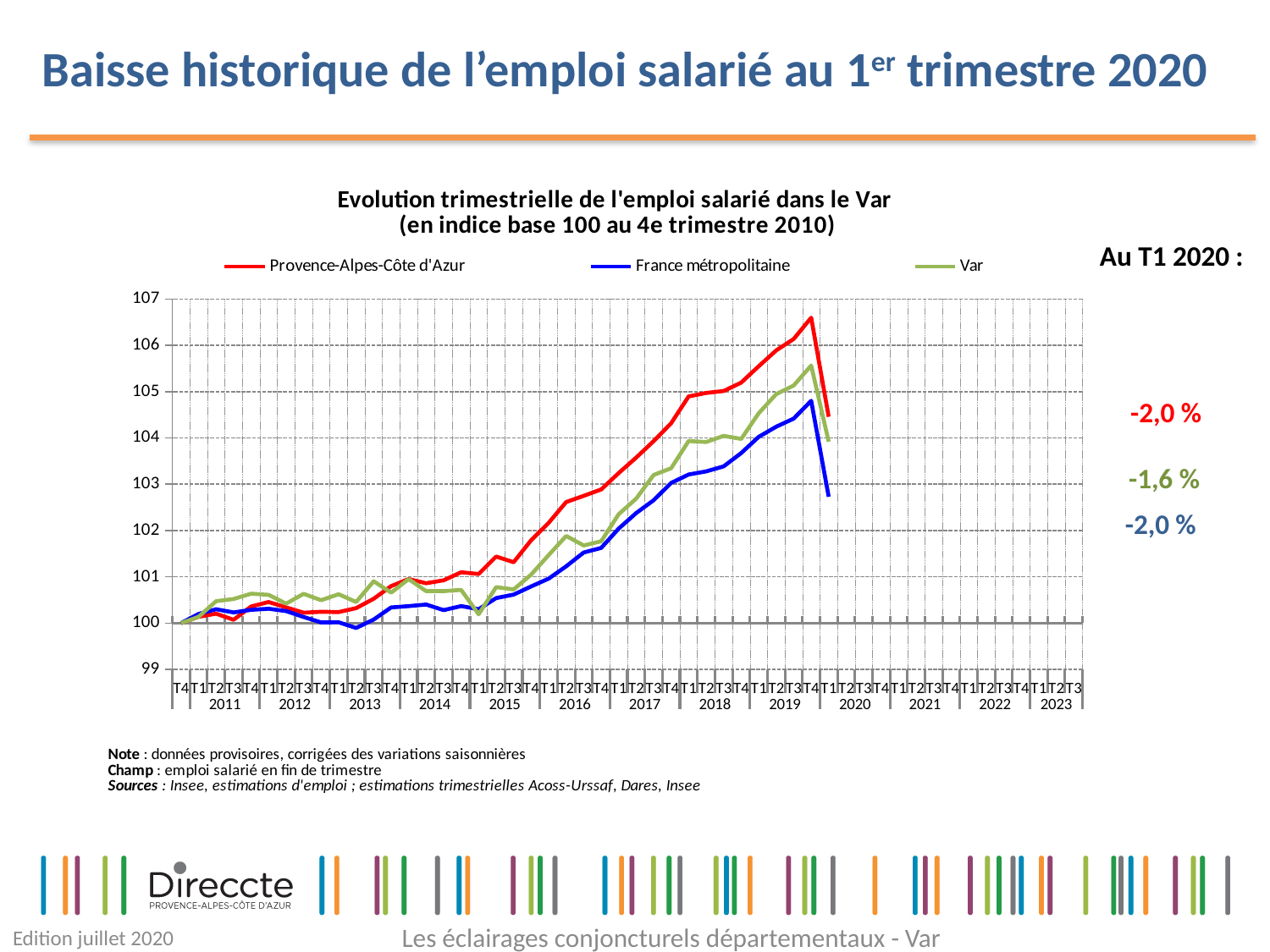
How many series does the legend of the chart list? 3 Which series is drawn in red on the chart? Provence-Alpes-Côte d'Azur Which series has the lowest index value at T1 2020? France métropolitaine Which series reaches the highest index value at T4 2019? Provence-Alpes-Côte d'Azur Is the value for Provence-Alpes-Côte d'Azur at T4 2019 greater or less than 106? greater What is the title of the chart? Evolution trimestrielle de l'emploi salarié dans le Var (en indice base 100 au 4e trimestre 2010) What kind of chart is shown on the slide? line chart According to the annotation on the right, what is the change for Var at T1 2020? -1,6 % Which series has the smallest decline at T1 2020 according to the annotations? Var Between 2015 and T4 2019, do the index values for the three series rise or fall? rise Is the value for France métropolitaine at T1 2020 greater or less than 103? less According to the annotation on the right, what is the change for Provence-Alpes-Côte d'Azur at T1 2020? -2,0 %